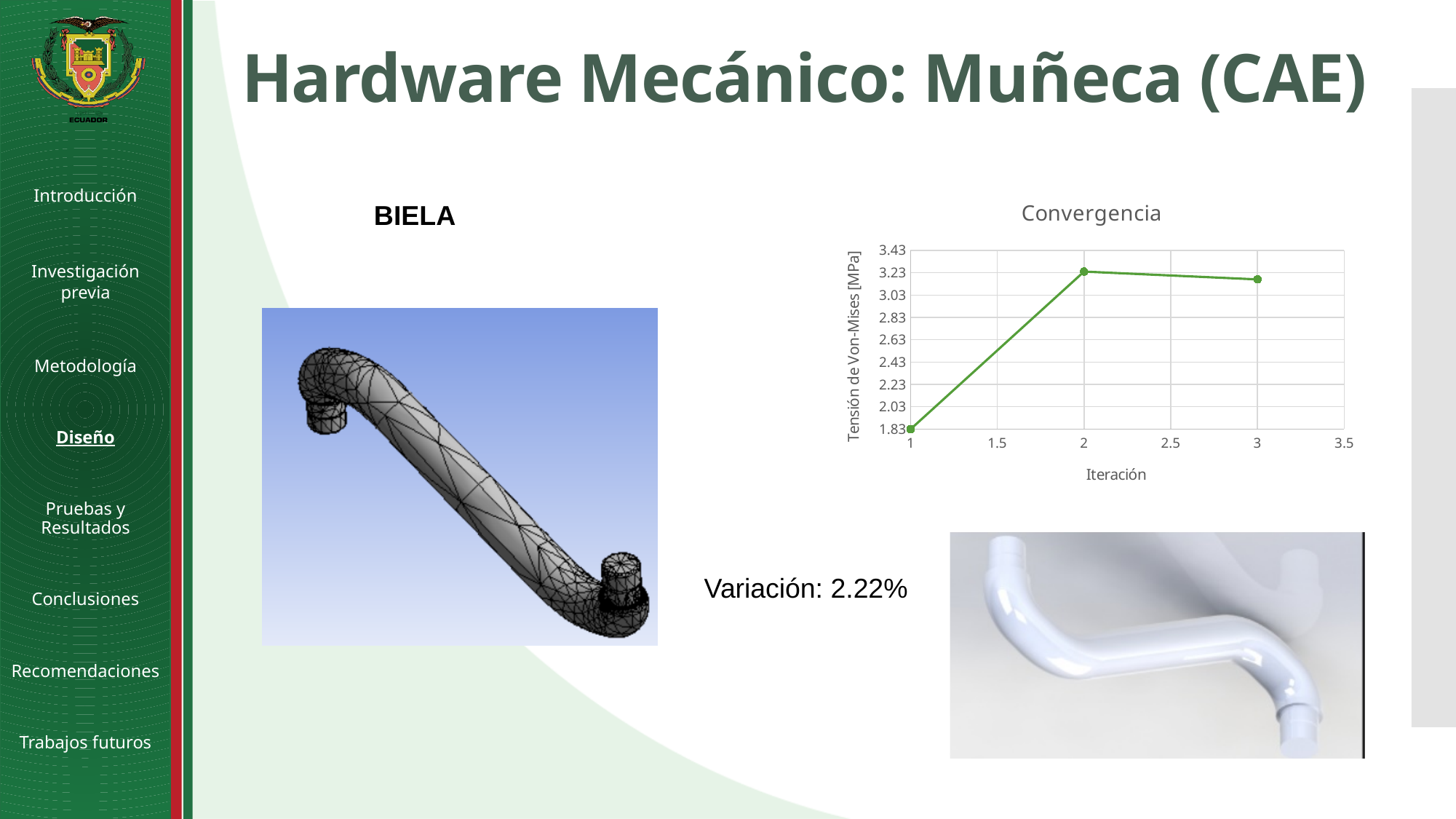
What is the title of the chart on the slide? Convergencia On the 'Convergencia' chart, is the value at iteration 3 greater or less than 3.03? greater On the 'Convergencia' chart, at which iteration is the Von-Mises stress lowest? 1 On the 'Convergencia' chart, does the Von-Mises stress rise or fall from iteration 1 to iteration 2? rise How many data points are plotted on the 'Convergencia' chart? 3 On the 'Convergencia' chart, is the value at iteration 2 greater or less than 3.03? greater What kind of chart is the 'Convergencia' chart? line chart What is the label of the x axis on the 'Convergencia' chart? Iteración On the 'Convergencia' chart, which has the larger Von-Mises stress: iteration 1 or iteration 3? iteration 3 On the 'Convergencia' chart, at which iteration is the Von-Mises stress highest? 2 On the 'Convergencia' chart, is the value at iteration 1 greater or less than 2.03? less